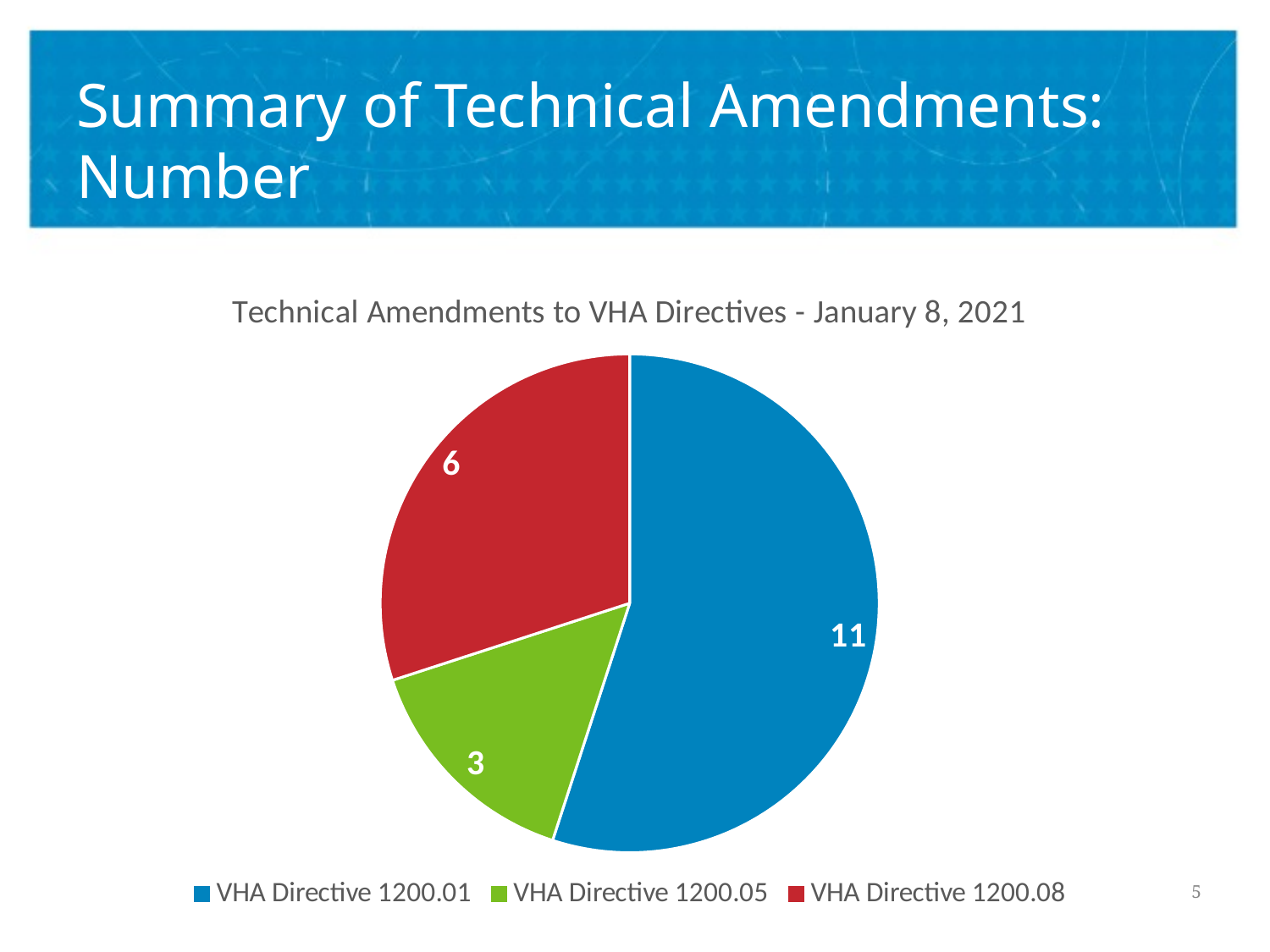
Which directive has the largest slice? VHA Directive 1200.01 What is the value for VHA Directive 1200.05? 3 What kind of chart is shown on the slide? pie chart Which directive has the smallest slice? VHA Directive 1200.05 Which is larger, the value for VHA Directive 1200.08 or VHA Directive 1200.05? VHA Directive 1200.08 What is the title of the chart? Technical Amendments to VHA Directives - January 8, 2021 What share of the pie does VHA Directive 1200.01 represent? 55% What is the value for VHA Directive 1200.01? 11 How many slices does the pie chart have? 3 What is the difference between the values for VHA Directive 1200.01 and VHA Directive 1200.08? 5 What is the total of all slices in the pie chart? 20 What is the value for VHA Directive 1200.08? 6